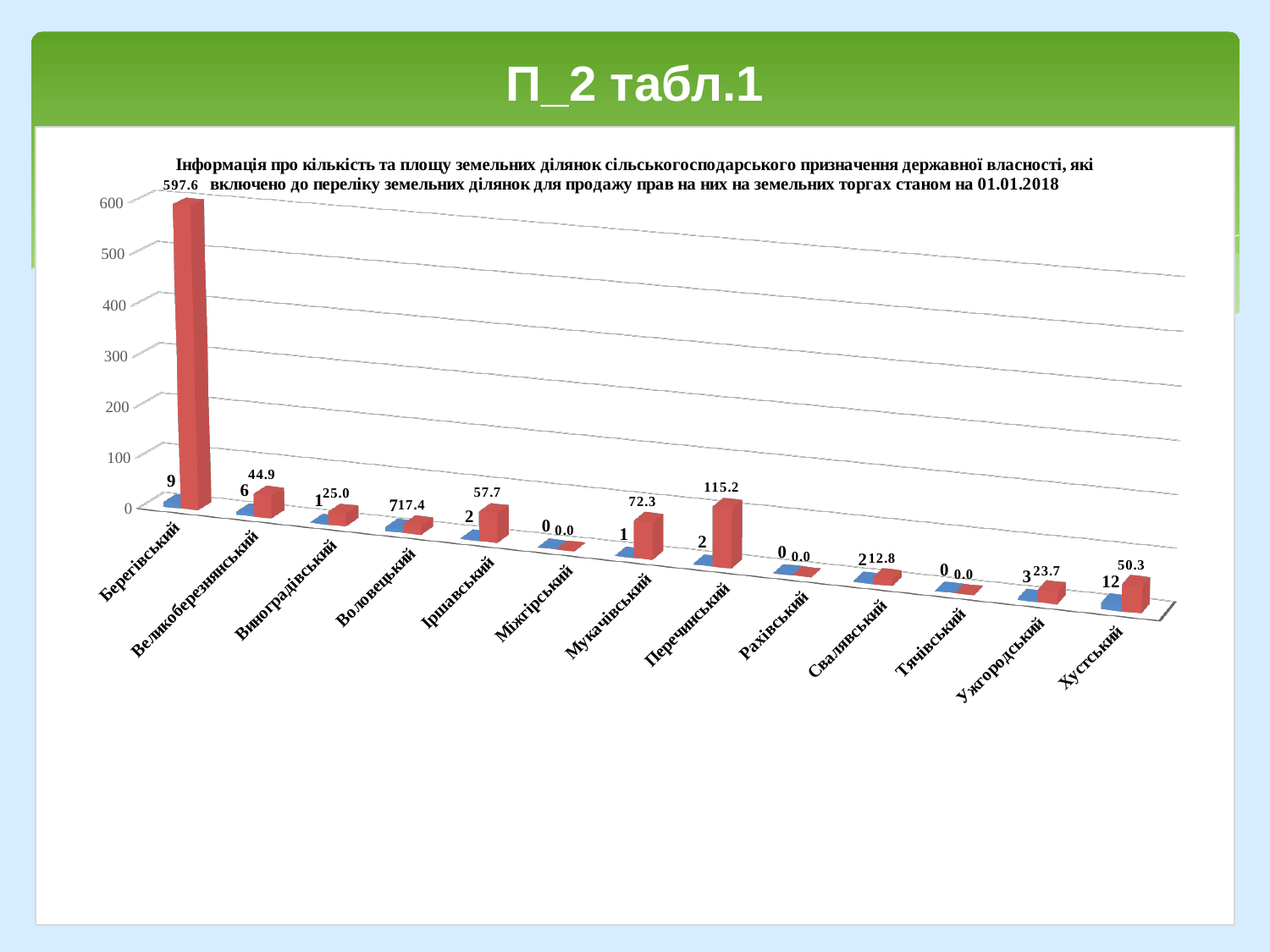
How many categories are shown on the x axis? 13 What kind of chart is shown on the slide? Bar chart What is the value of the red bar for Берегівський? 597.6 Which has a larger red bar value, Великоберезнянський or Хустський? Хустський What is the difference between the red bar values for Перечинський and Іршавський? 57.5 Which category has the highest blue bar? Хустський What is the value of the blue bar for Хустський? 12 What is the value of the red bar for Перечинський? 115.2 What is the difference between the blue bar values for Хустський and Берегівський? 3 Is the red bar value for Берегівський greater or less than 500? greater Which category has the highest red bar? Берегівський What is the value of the red bar for Мукачівський? 72.3